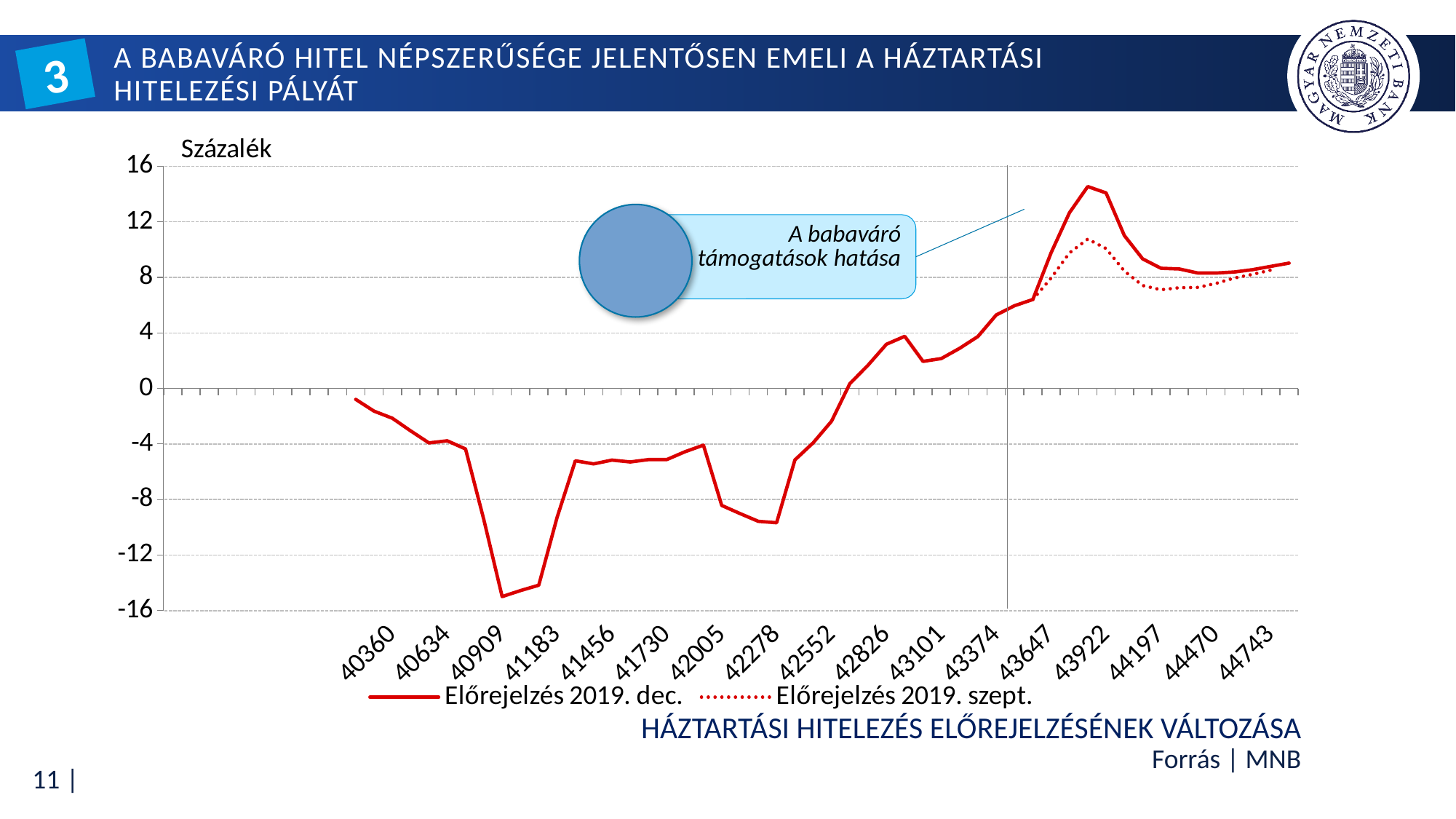
Is the peak value of the Előrejelzés 2019. dec. line near 43922 greater or less than 12? greater Is the value of the Előrejelzés 2019. dec. line at 42278 greater or less than -8? less How many category labels are shown on the x axis? 17 Around which x-axis label does the Előrejelzés 2019. dec. line reach its lowest point? 40909 What is the title of the chart? HÁZTARTÁSI HITELEZÉS ELŐREJELZÉSÉNEK VÁLTOZÁSA Is the peak value of the Előrejelzés 2019. szept. line near 43922 greater or less than 12? less What are the two series named in the legend? Előrejelzés 2019. dec. and Előrejelzés 2019. szept. Does the Előrejelzés 2019. dec. line rise or fall between 42278 and 43647? rise What kind of chart is shown on the slide? line chart How many series does the legend list? 2 Near 43922, which series has the higher value: Előrejelzés 2019. dec. or Előrejelzés 2019. szept.? Előrejelzés 2019. dec.